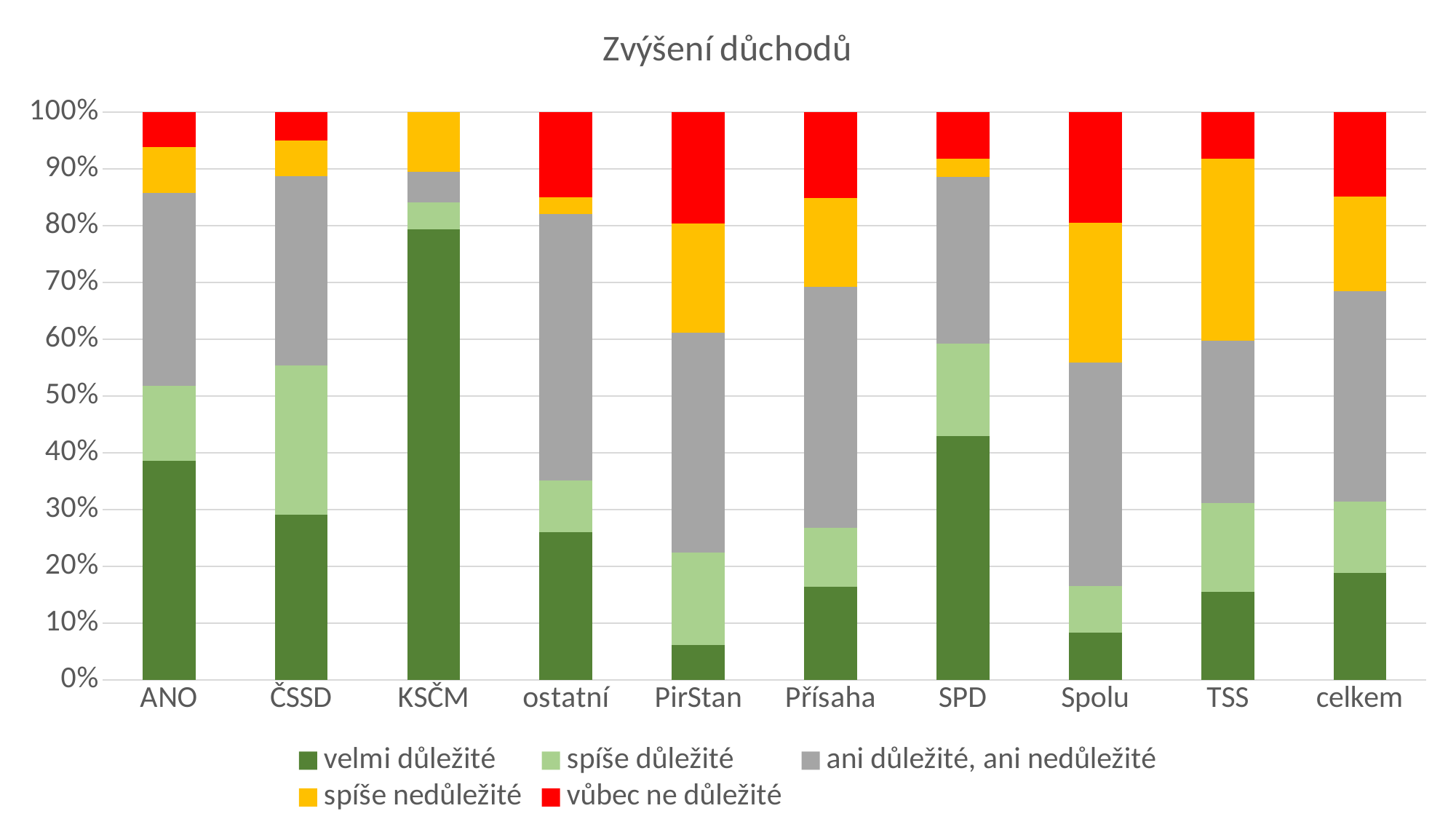
Which category has the smallest share of 'velmi důležité'? PirStan Which has a larger 'velmi důležité' share, ANO or ČSSD? ANO What is the title of the chart? Zvýšení důchodů Which category has the smallest share of 'vůbec ne důležité'? KSČM Is the 'velmi důležité' share for KSČM greater or less than 70%? greater How many categories are shown on the x axis? 10 Which category has the largest share of 'spíše nedůležité'? TSS Which category has the largest share of 'velmi důležité'? KSČM How many series does the legend list? 5 Which colour represents 'vůbec ne důležité' in the legend? red Is the 'velmi důležité' share for PirStan greater or less than 10%? less What kind of chart is shown on the slide? stacked bar chart